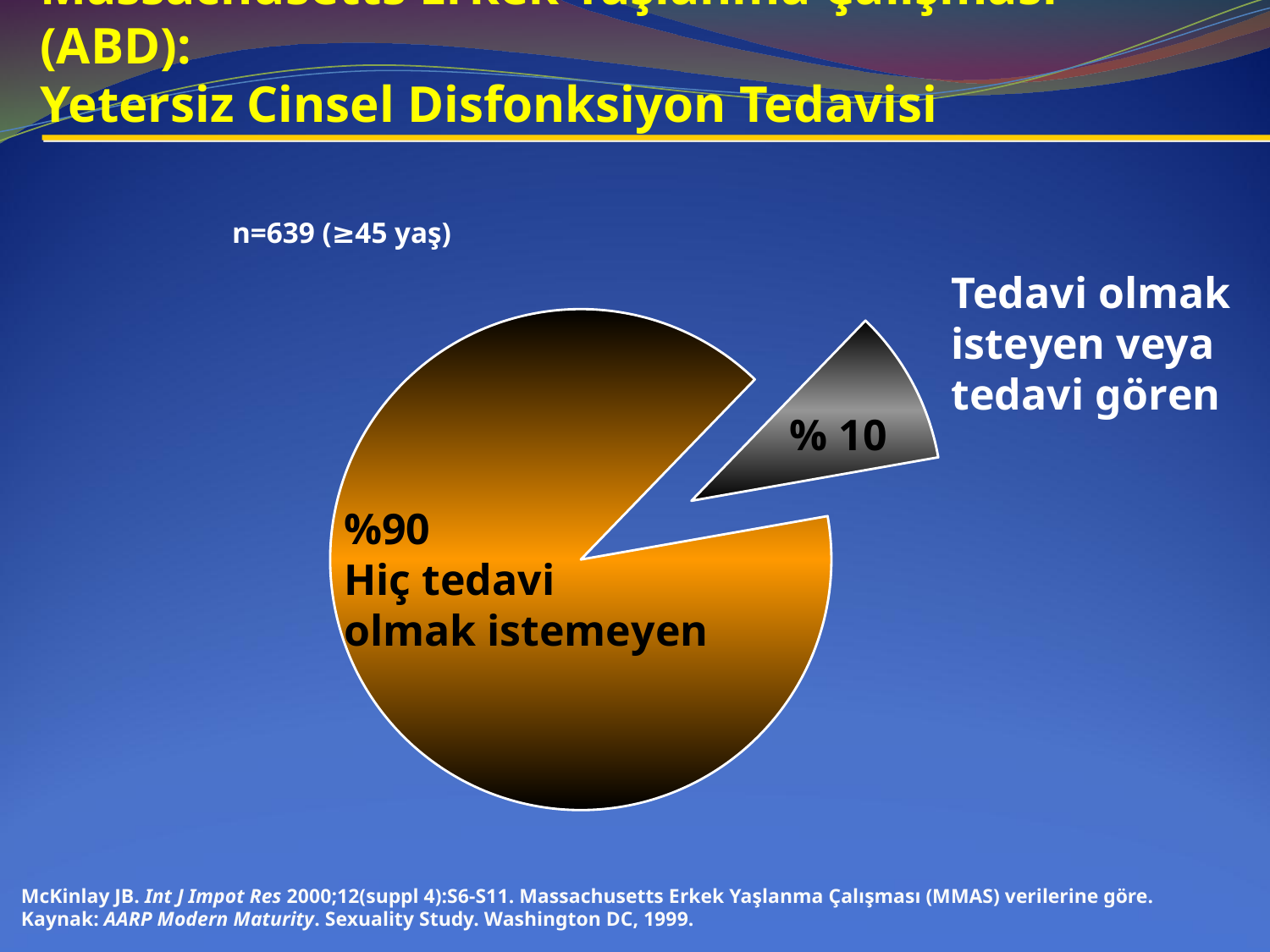
How many slices does the pie chart have? 2 Which is larger: the share for "Hiç tedavi olmak istemeyen" or the share for "Tedavi olmak isteyen veya tedavi gören"? Hiç tedavi olmak istemeyen What share of the pie is labelled "Hiç tedavi olmak istemeyen"? %90 Which slice of the pie chart is pulled out (exploded) from the rest of the pie? Tedavi olmak isteyen veya tedavi gören What share of the pie is labelled "Tedavi olmak isteyen veya tedavi gören"? % 10 Which slice of the pie chart is the smallest? Tedavi olmak isteyen veya tedavi gören What kind of chart is shown on the slide? Pie chart What is the sample size (n) stated above the pie chart? n=639 (≥45 yaş) What is the difference in percentage points between the "Hiç tedavi olmak istemeyen" slice and the "Tedavi olmak isteyen veya tedavi gören" slice? 80 Which slice of the pie chart is the largest? Hiç tedavi olmak istemeyen